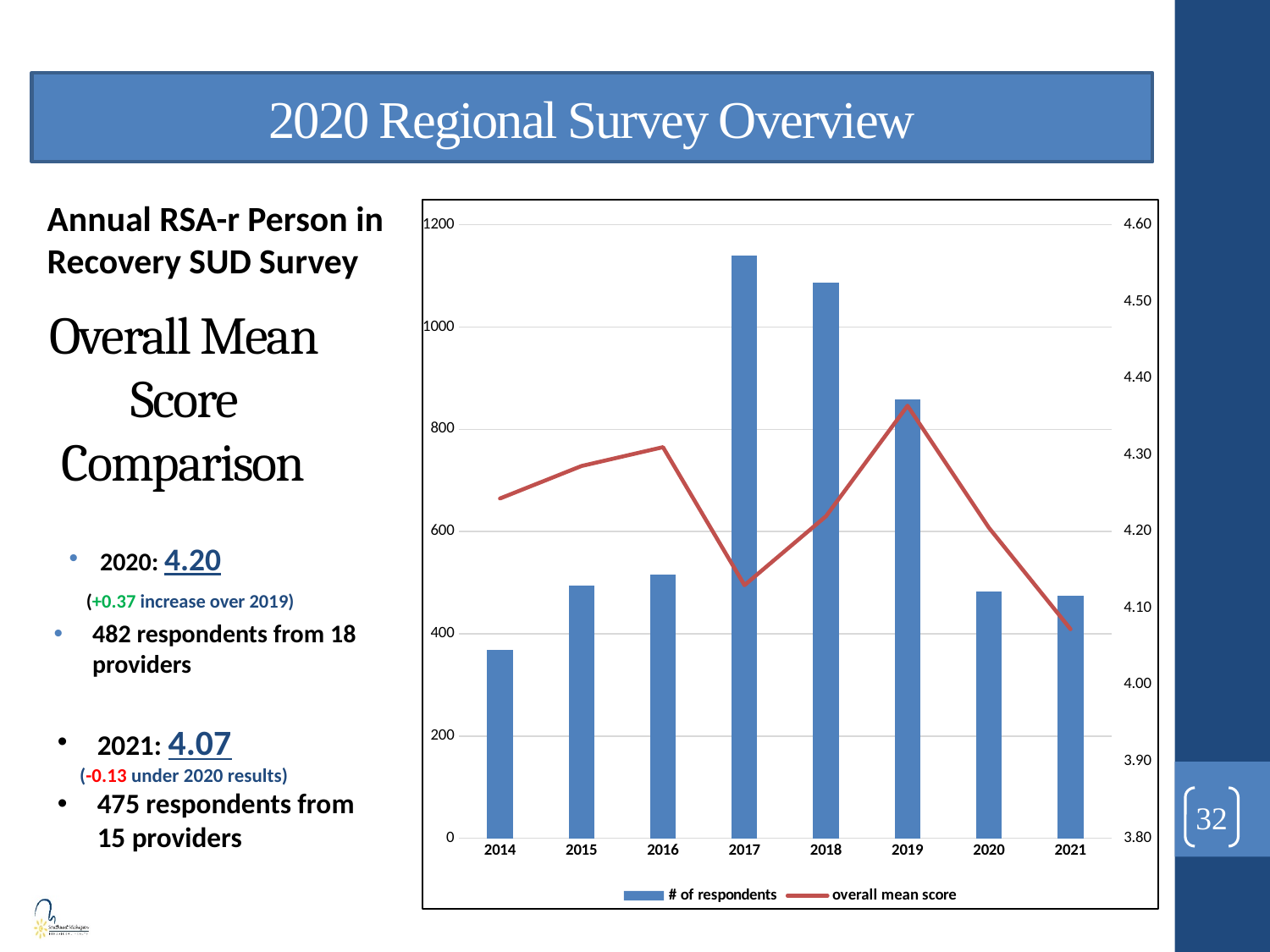
Is the number of respondents in 2014 greater or less than 400? less Which year has the highest overall mean score? 2019 How many years are shown on the x axis of the chart? 8 Which year has the highest number of respondents? 2017 Which year had more respondents, 2017 or 2018? 2017 Does the overall mean score rise or fall from 2019 to 2021? fall How many series does the chart legend list? 2 Which year has the lowest number of respondents? 2014 What was the overall mean score in 2021? 4.07 Is the number of respondents in 2017 greater or less than 1000? greater What kind of chart is shown on the slide? A bar chart combined with a line How many respondents were there in 2020? 482